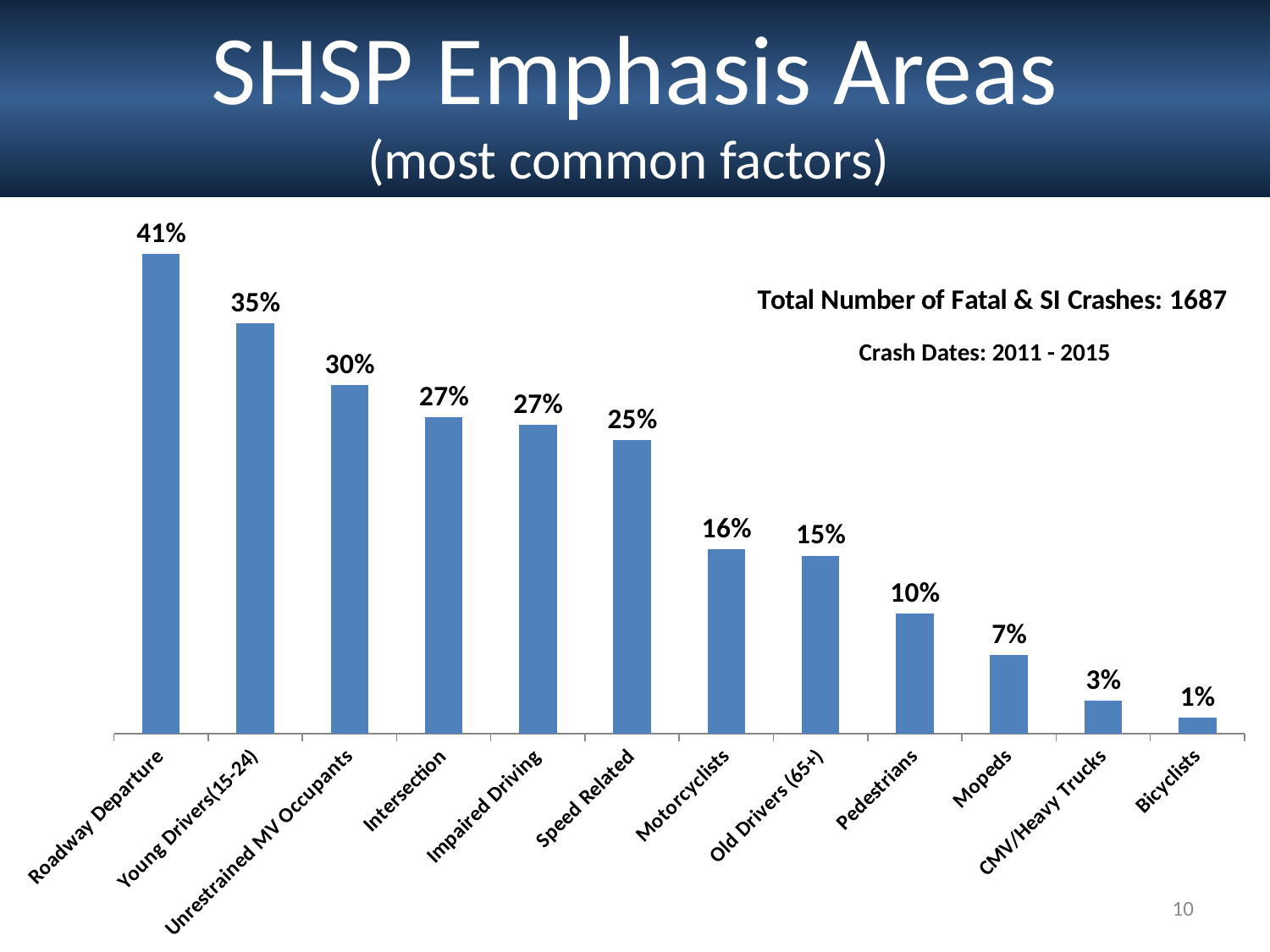
What crash date range is stated on the slide? 2011 - 2015 How many categories are shown in the chart? 12 What is the difference between the values for Young Drivers(15-24) and Unrestrained MV Occupants? 5% What is the value for Roadway Departure? 41% What is the value for Motorcyclists? 16% What kind of chart is shown on the slide? Bar chart Which category has the highest value? Roadway Departure What is the value for Pedestrians? 10% Do the values rise or fall from left to right along the x axis? Fall What is the total number of Fatal & SI crashes stated on the slide? 1687 Which is larger, the value for Speed Related or the value for Old Drivers (65+)? Speed Related Which category has the lowest value? Bicyclists